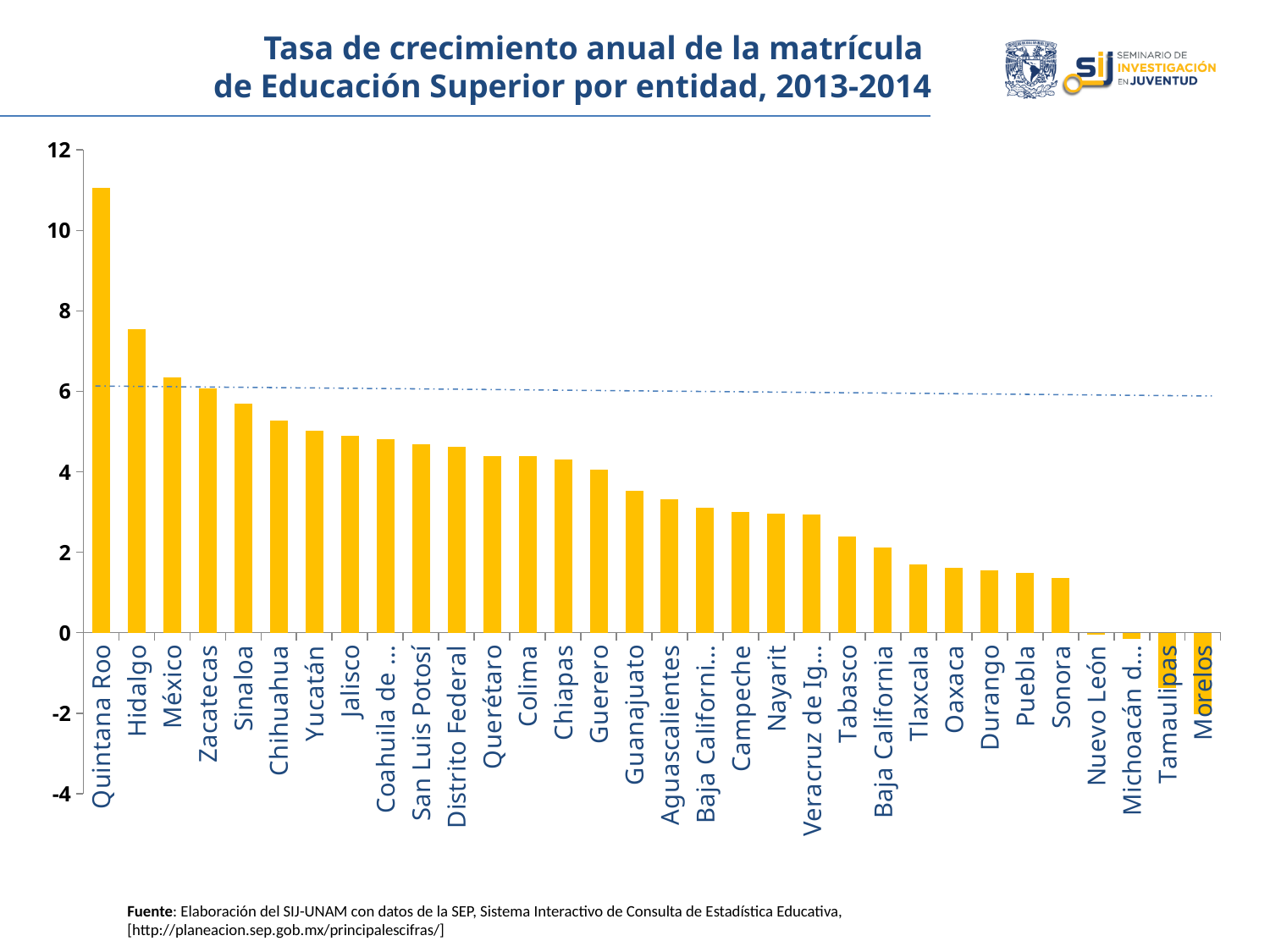
Do the bar values rise or fall moving from left to right along the x axis? fall Is the value for Sinaloa greater or less than 6? less What is the title of the chart? Tasa de crecimiento anual de la matrícula de Educación Superior por entidad, 2013-2014 What kind of chart is shown on the slide? bar chart Is the value for Quintana Roo greater or less than 10? greater Is the value for Hidalgo greater or less than 6? greater How many entities (bars) are plotted in the chart? 32 Which entity has the highest annual growth rate in the chart? Quintana Roo Which has a higher growth rate, Hidalgo or Sinaloa? Hidalgo